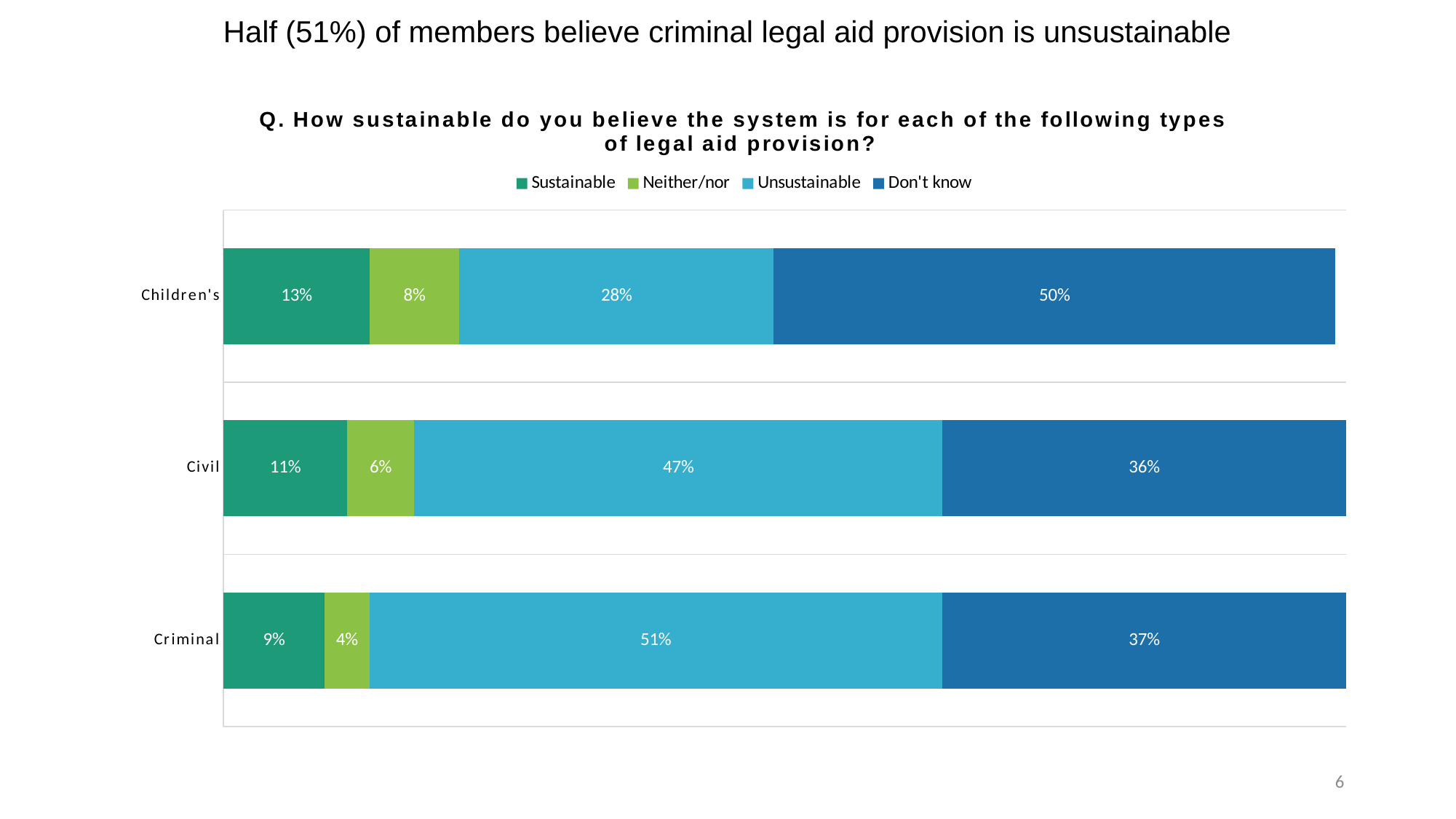
Which is larger: the 'Don't know' value for Civil or for Criminal? Criminal How many series does the legend list? 4 What is the 'Neither/nor' value for Criminal? 4% Which type of legal aid provision has the highest 'Unsustainable' percentage? Criminal Which type of legal aid provision has the lowest 'Sustainable' percentage? Criminal What percentage of members said civil legal aid provision is sustainable? 11% How many types of legal aid provision are shown on the chart? 3 What percentage of members said criminal legal aid provision is unsustainable? 51% What is the total of the Children's bar across all four segments? 99% What kind of chart is shown on the slide? Stacked bar chart What is the difference between the 'Unsustainable' values for Civil and Children's? 19 percentage points What is the 'Don't know' value for Children's legal aid provision? 50%